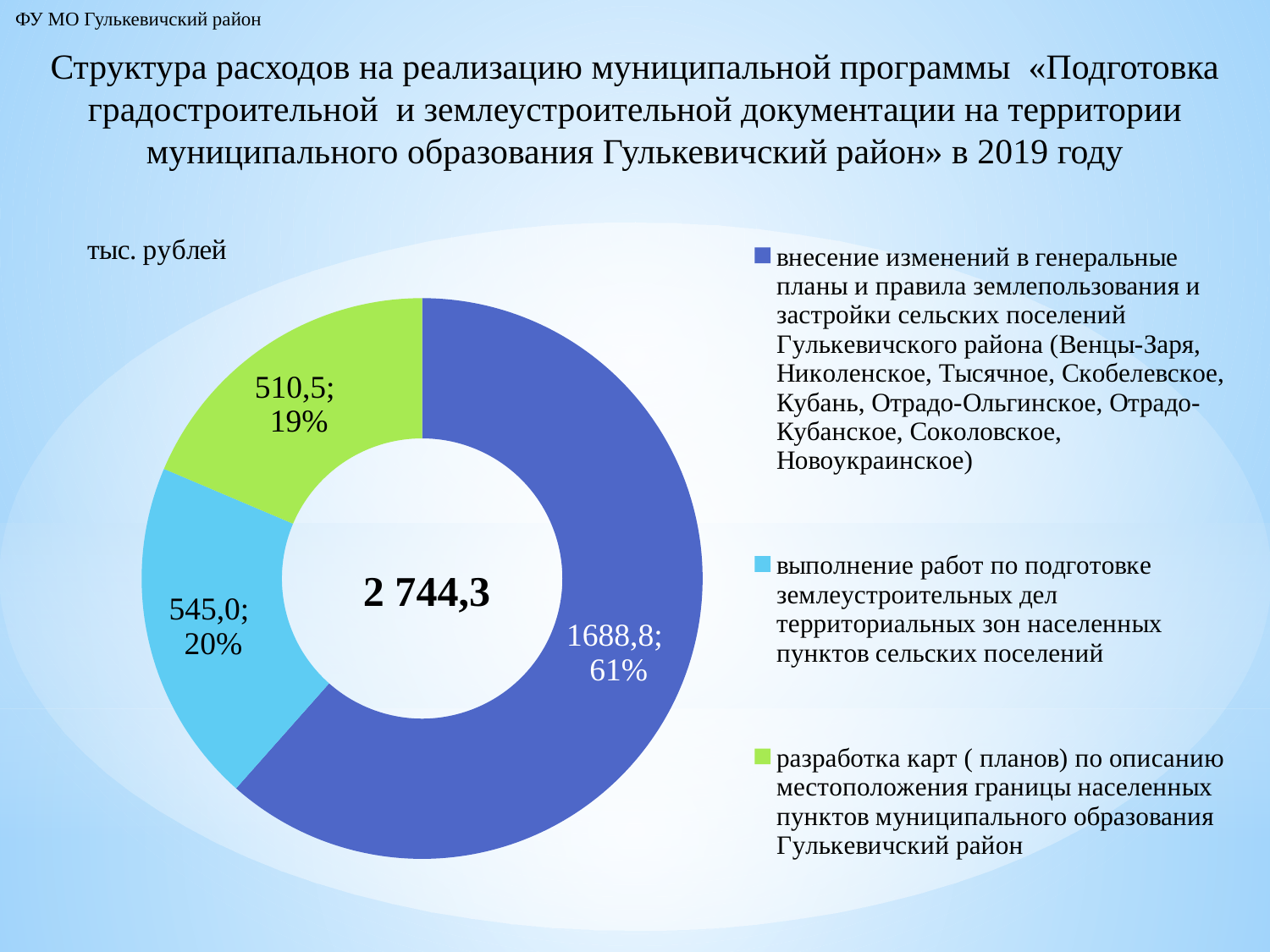
Which category has the largest expenditure? внесение изменений в генеральные планы и правила землепользования и застройки сельских поселений How many slices does the chart have? 3 What is the value (тыс. рублей) for «внесение изменений в генеральные планы и правила землепользования и застройки сельских поселений»? 1688,8 What share of the total does «внесение изменений в генеральные планы и правила землепользования и застройки» account for? 61% What type of chart is shown on the slide? doughnut (pie) chart What is the value (тыс. рублей) for «разработка карт (планов) по описанию местоположения границы населенных пунктов»? 510,5 How many entries does the legend list? 3 Which category has the smallest expenditure? разработка карт (планов) по описанию местоположения границы населенных пунктов What is the difference between the expenditure on «внесение изменений в генеральные планы» (1688,8) and on «выполнение работ по подготовке землеустроительных дел» (545,0)? 1143,8 What is the value (тыс. рублей) for «выполнение работ по подготовке землеустроительных дел территориальных зон населенных пунктов сельских поселений»? 545,0 What total value is shown in the centre of the doughnut chart? 2 744,3 What share of the total does «разработка карт (планов) по описанию местоположения границы населенных пунктов» account for? 19%